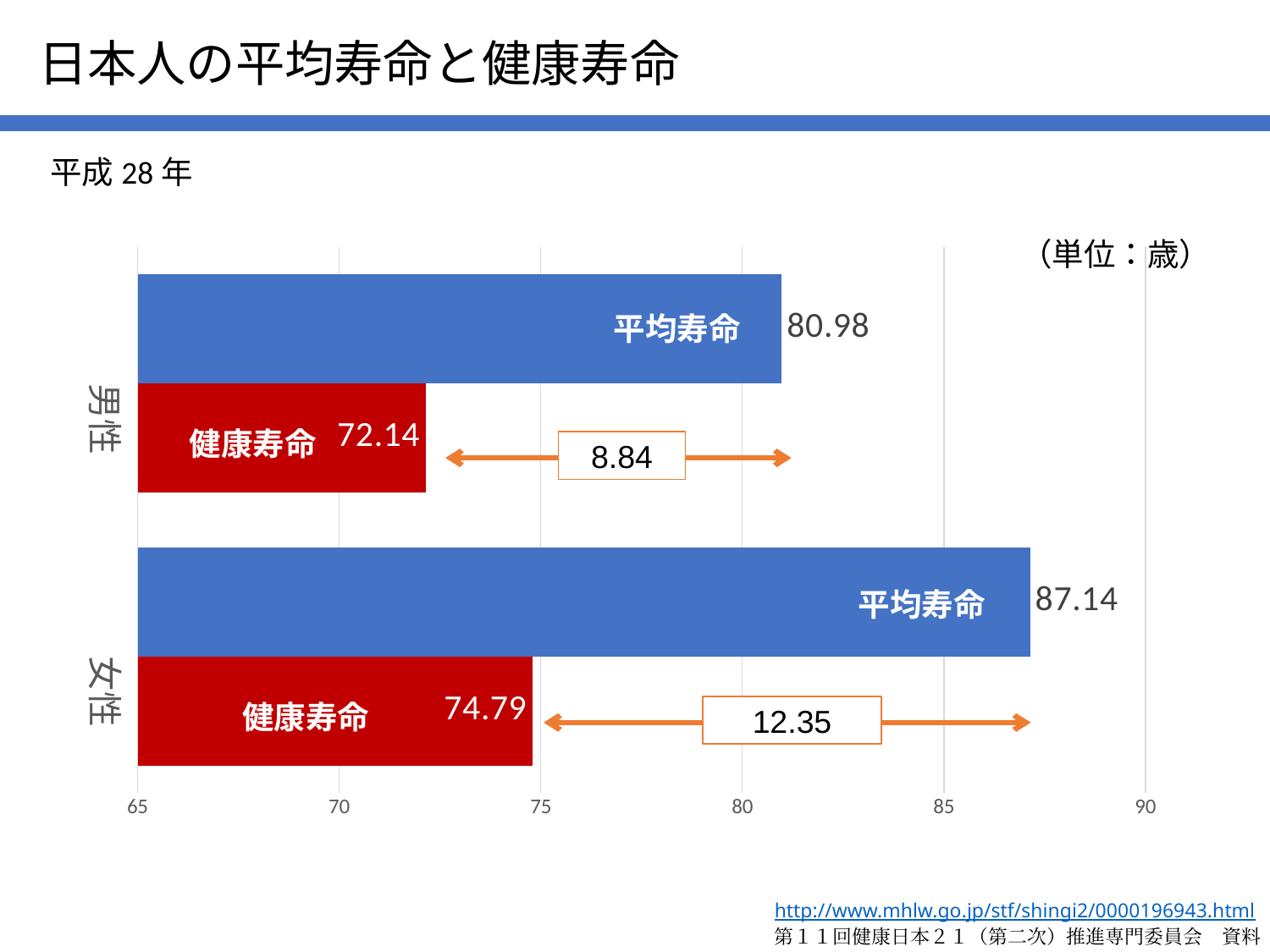
What is the difference between 平均寿命 and 健康寿命 for 女性, as shown on the slide? 12.35 What is the 平均寿命 (average life expectancy) value for 男性 (men)? 80.98 What is the 健康寿命 (healthy life expectancy) value for 女性 (women)? 74.79 What is the 平均寿命 value for 女性? 87.14 What unit is stated for the values in the chart? 歳 Which is larger, the 健康寿命 for 男性 or the 健康寿命 for 女性? 女性 Which of the four bars has the highest value? 女性 平均寿命 What is the 健康寿命 value for 男性? 72.14 What kind of chart is shown on the slide? bar chart What is the difference between 平均寿命 and 健康寿命 for 男性, as shown on the slide? 8.84 Which of the four bars has the lowest value? 男性 健康寿命 Is the 平均寿命 for 男性 greater or less than 80? greater